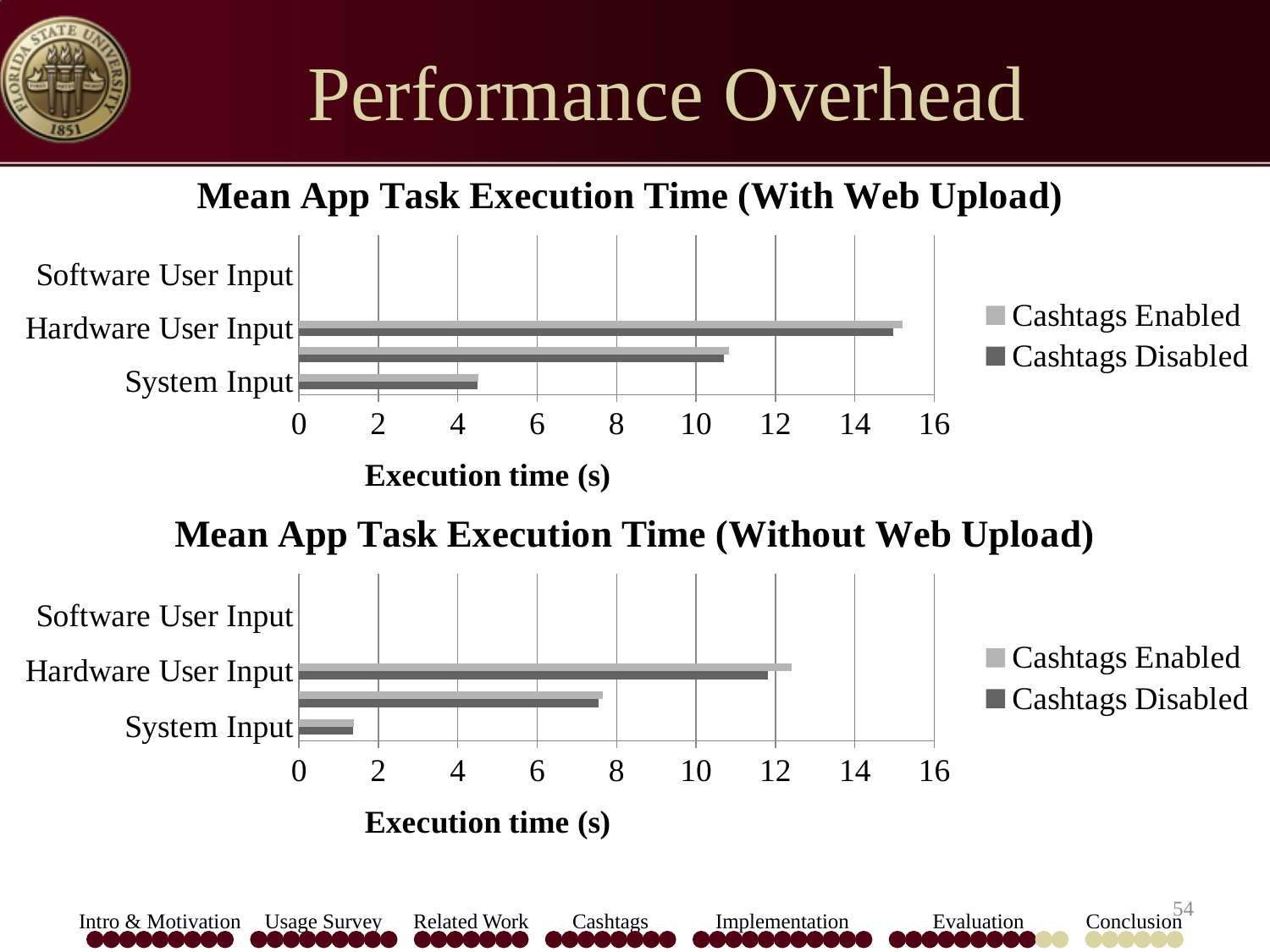
In the bottom chart, is the longest bar greater or less than 14? less In the bottom chart, is the shortest bar greater or less than 2? less Which chart has the longer longest bar, the top chart (With Web Upload) or the bottom chart (Without Web Upload)? the top chart (With Web Upload) What kind of chart is the top chart, 'Mean App Task Execution Time (With Web Upload)'? bar chart In the top chart, is the longest bar greater or less than 14? greater What is the horizontal axis label of the bottom chart? Execution time (s) How many categories are shown on the vertical axis of the top chart? 3 How many categories are shown on the vertical axis of the bottom chart? 3 How many series does the legend of the bottom chart list? 2 What is the title of the top chart? Mean App Task Execution Time (With Web Upload) How many series does the legend of the top chart list? 2 What kind of chart is the bottom chart, 'Mean App Task Execution Time (Without Web Upload)'? bar chart